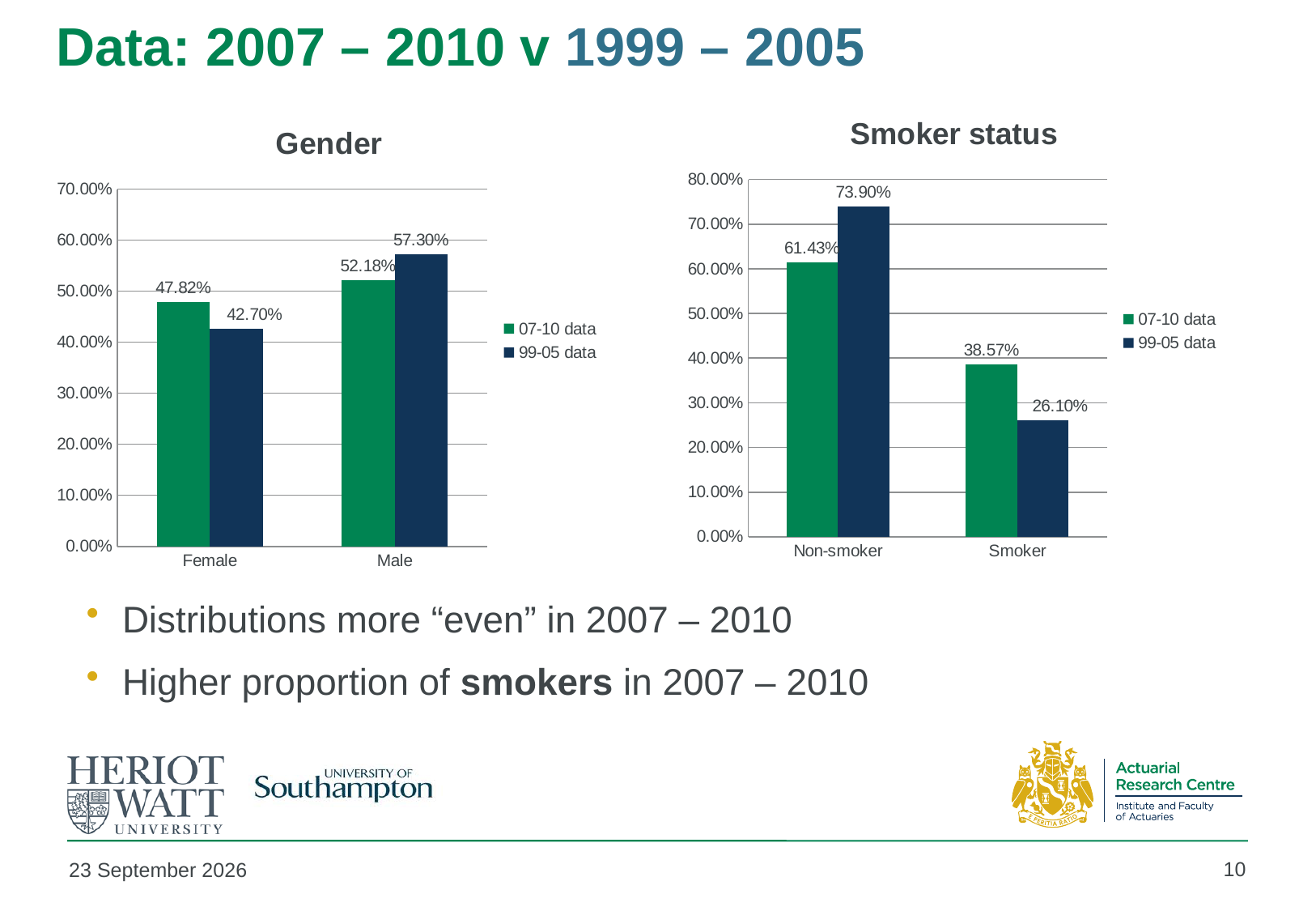
In the Gender chart, what is the value for Male in the 99-05 data series? 57.30% In the Gender chart, what is the difference between the 99-05 data and 07-10 data values for Male? 5.12% What kind of chart is the Gender chart? Bar chart How many series does the legend of the Smoker status chart list? 2 In the Smoker status chart, what is the value for Non-smoker in the 99-05 data series? 73.90% In the Smoker status chart, is the 07-10 data value for Non-smoker greater or less than 60.00%? greater In the Gender chart, which is larger for Female: the 07-10 data value or the 99-05 data value? 07-10 data How many categories are shown on the x axis of the Gender chart? 2 In the Gender chart, what is the value for Female in the 07-10 data series? 47.82% In the Smoker status chart, what is the difference between the 07-10 data and 99-05 data values for Smoker? 12.47% In the Smoker status chart, which category has the lowest value in the 99-05 data series? Smoker In the Smoker status chart, what is the value for Smoker in the 07-10 data series? 38.57%